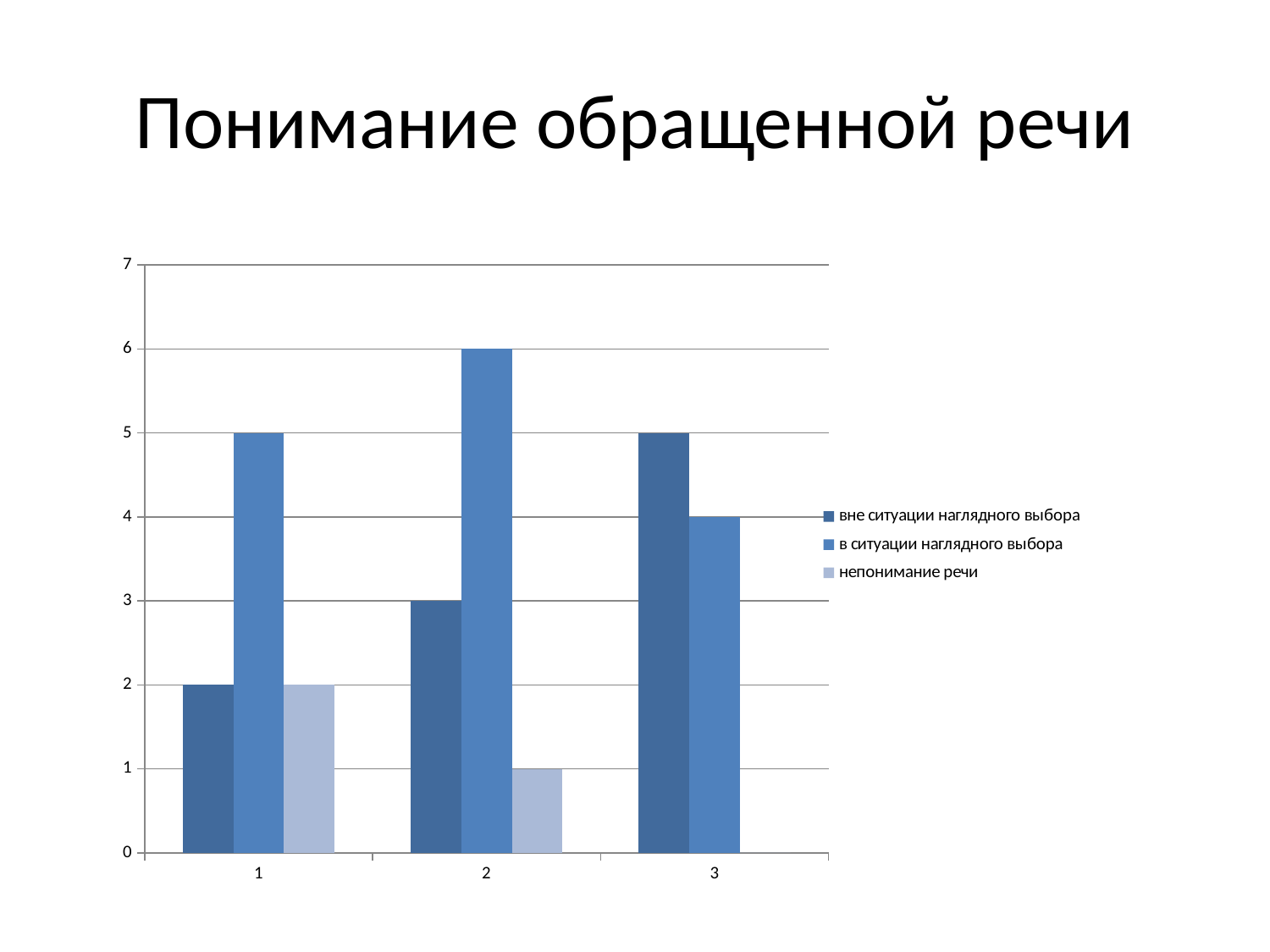
What is the difference between 'в ситуации наглядного выбора' and 'вне ситуации наглядного выбора' in category 2? 3 What is the value for 'в ситуации наглядного выбора' in category 2? 6 How many categories are shown on the x axis? 3 What is the title of the slide? Понимание обращенной речи In which category is the value for 'в ситуации наглядного выбора' highest? 2 In category 3, which is larger: 'вне ситуации наглядного выбора' or 'в ситуации наглядного выбора'? вне ситуации наглядного выбора What is the value for 'непонимание речи' in category 1? 2 Does the value for 'вне ситуации наглядного выбора' rise or fall from category 1 to category 3? rise What kind of chart is shown on the slide? bar chart How many series does the legend list? 3 What is the value for 'вне ситуации наглядного выбора' in category 3? 5 In which category is the value for 'вне ситуации наглядного выбора' lowest? 1